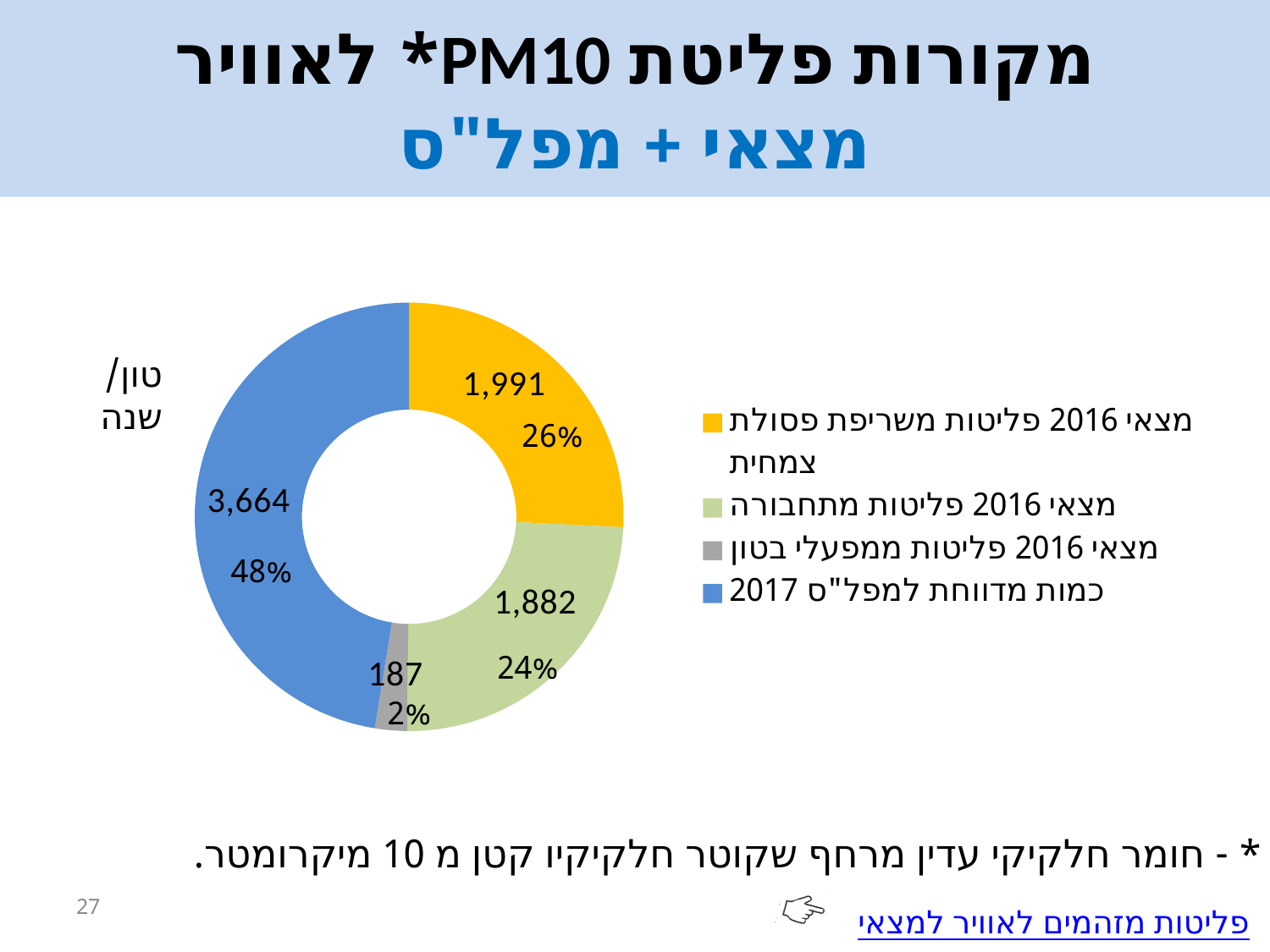
Which slice has the smallest value? מצאי 2016 פליטות ממפעלי בטון What kind of chart is shown on the slide? doughnut chart What value is shown for the slice labelled מצאי 2016 פליטות מתחבורה? 1,882 How many slices does the chart have? 4 What value is shown for the slice labelled כמות מדווחת למפל"ס 2017? 3,664 What percentage share does the slice כמות מדווחת למפל"ס 2017 have? 48% What percentage share does the slice מצאי 2016 פליטות מתחבורה have? 24% What is the difference between the value for כמות מדווחת למפל"ס 2017 and the value for מצאי 2016 פליטות משריפת פסולת צמחית? 1,673 What value is shown for the slice labelled מצאי 2016 פליטות ממפעלי בטון? 187 What value is shown for the slice labelled מצאי 2016 פליטות משריפת פסולת צמחית? 1,991 Which slice has the largest value? כמות מדווחת למפל"ס 2017 Which is larger: the value for מצאי 2016 פליטות משריפת פסולת צמחית or the value for מצאי 2016 פליטות מתחבורה? מצאי 2016 פליטות משריפת פסולת צמחית